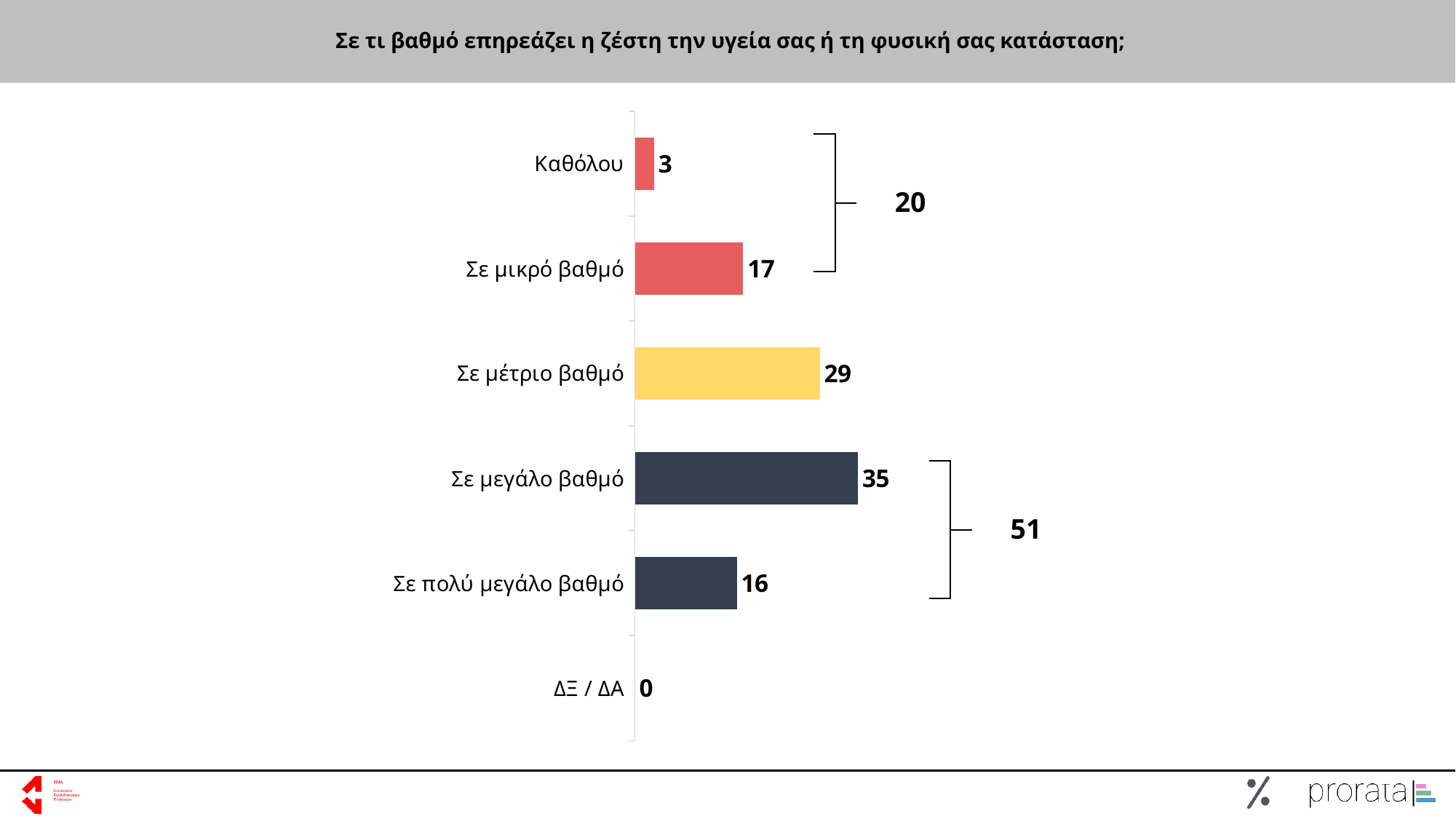
What is the value for "Καθόλου"? 3 What is the value for "ΔΞ / ΔΑ"? 0 What is the value for "Σε μεγάλο βαθμό"? 35 Which is larger, the value for "Σε μικρό βαθμό" or the value for "Σε πολύ μεγάλο βαθμό"? Σε μικρό βαθμό What is the value for "Σε μέτριο βαθμό"? 29 How many categories are shown on the chart? 6 What combined value is shown by the bracket grouping "Σε μεγάλο βαθμό" and "Σε πολύ μεγάλο βαθμό"? 51 What kind of chart is shown on the slide? Bar chart Which category has the highest value? Σε μεγάλο βαθμό What is the title of the chart? Σε τι βαθμό επηρεάζει η ζέστη την υγεία σας ή τη φυσική σας κατάσταση; Which category has the lowest value? ΔΞ / ΔΑ What is the difference between the values for "Σε μεγάλο βαθμό" and "Σε μέτριο βαθμό"? 6